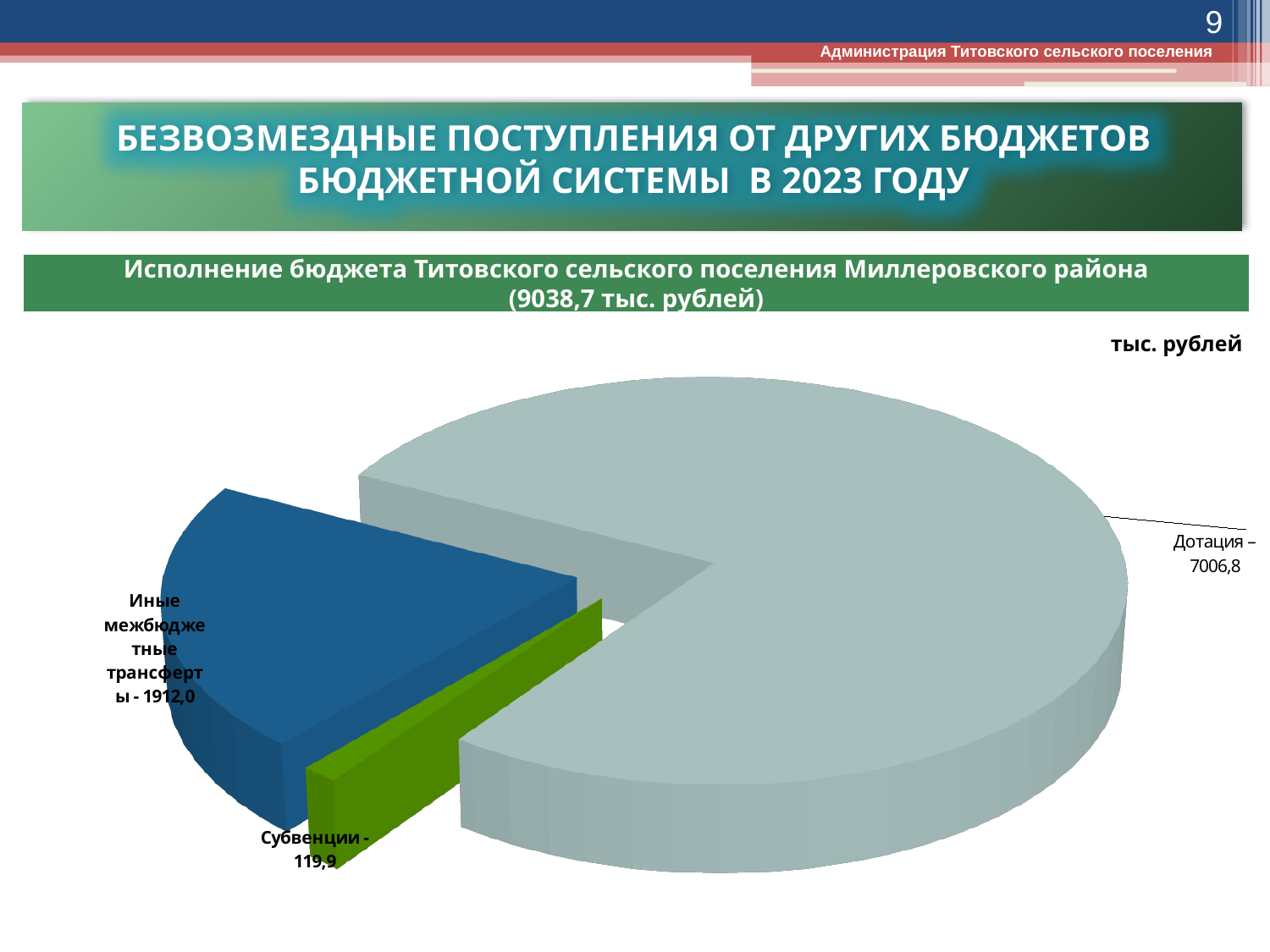
What is the total of all three slices of the pie chart? 9038,7 How many slices does the pie chart have? 3 What is the difference between the values for Дотация and Иные межбюджетные трансферты? 5094,8 In what units are the values of the pie chart given? тыс. рублей What is the value for Дотация? 7006,8 What type of chart is shown on the slide? Pie chart Which category has the smallest slice of the pie? Субвенции What is the difference between the values for Иные межбюджетные трансферты and Субвенции? 1792,1 What is the value for Иные межбюджетные трансферты? 1912,0 What is the value for Субвенции? 119,9 Which category has the largest slice of the pie? Дотация Which is larger, the value for Субвенции or the value for Иные межбюджетные трансферты? Иные межбюджетные трансферты